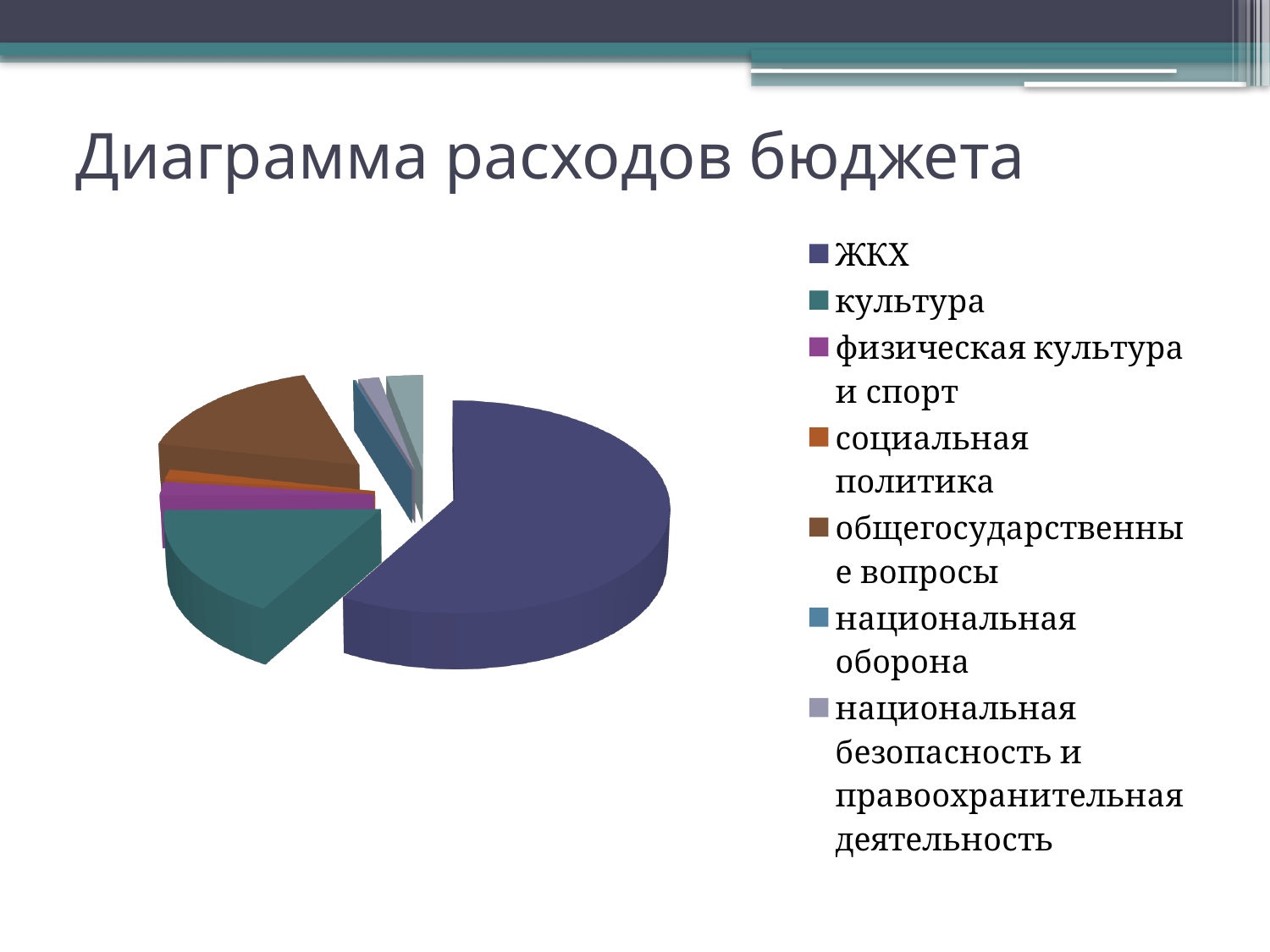
Which slice is larger, общегосударственные вопросы or физическая культура и спорт? общегосударственные вопросы What is the title of the chart on the slide? Диаграмма расходов бюджета What kind of chart is shown on the slide? pie chart How many categories does the pie chart's legend list? 7 Which category is listed first in the legend? ЖКХ Which slice is larger, ЖКХ or культура? ЖКХ Which slice is larger, ЖКХ or общегосударственные вопросы? ЖКХ Which category has the largest slice of the pie? ЖКХ